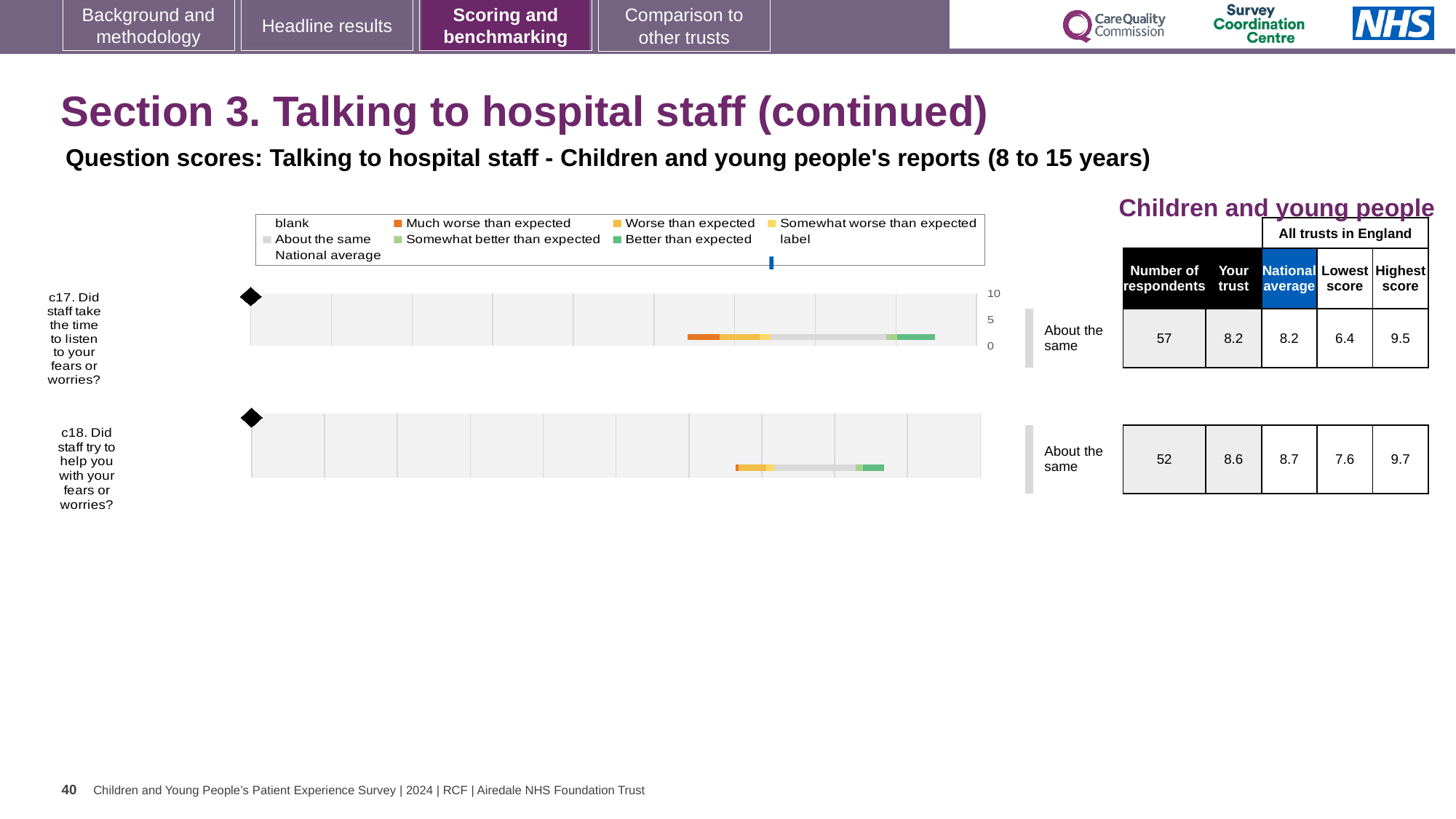
What benchmark category is shown next to the chart for question c17? About the same How many respondents are shown for question c17 (Did staff take the time to listen to your fears or worries?)? 57 What is the difference between the national average and the 'Your trust' score for question c18? 0.1 What is the national average score for question c17? 8.2 What is the highest score among all trusts in England for question c18? 9.7 What is the lowest score among all trusts in England for question c17? 6.4 How many questions are plotted on this slide? 2 What is the 'Your trust' score for question c18 (Did staff try to help you with your fears or worries?)? 8.6 What is the difference between the highest and lowest scores for question c18? 2.1 Which question has more respondents, c17 or c18? c17 What kind of chart is used to show the question scores on this slide? Bar chart Which colour does the legend use for 'Much worse than expected'? Orange